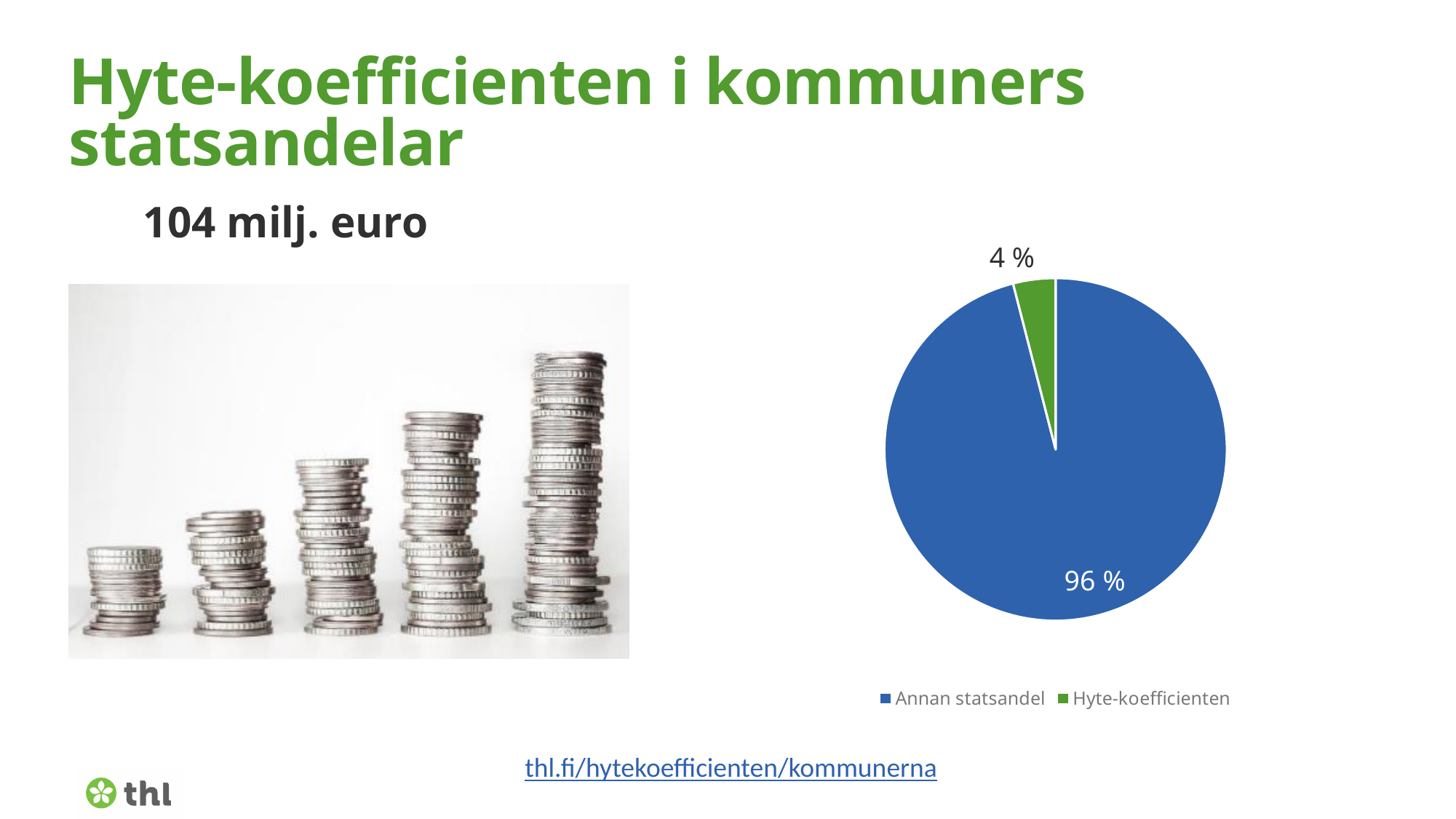
Which is larger, Annan statsandel or Hyte-koefficienten? Annan statsandel What colour is the Hyte-koefficienten slice? green What is the difference in percentage points between Annan statsandel and Hyte-koefficienten? 92 percentage points How many slices does the pie chart have? 2 What share of the pie does Annan statsandel have? 96 % What kind of chart is shown on the slide? pie chart Which slice of the pie is the smallest? Hyte-koefficienten Which slice of the pie is the largest? Annan statsandel How many entries does the legend list? 2 What colour is the Annan statsandel slice? blue What share of the pie does Hyte-koefficienten have? 4 %